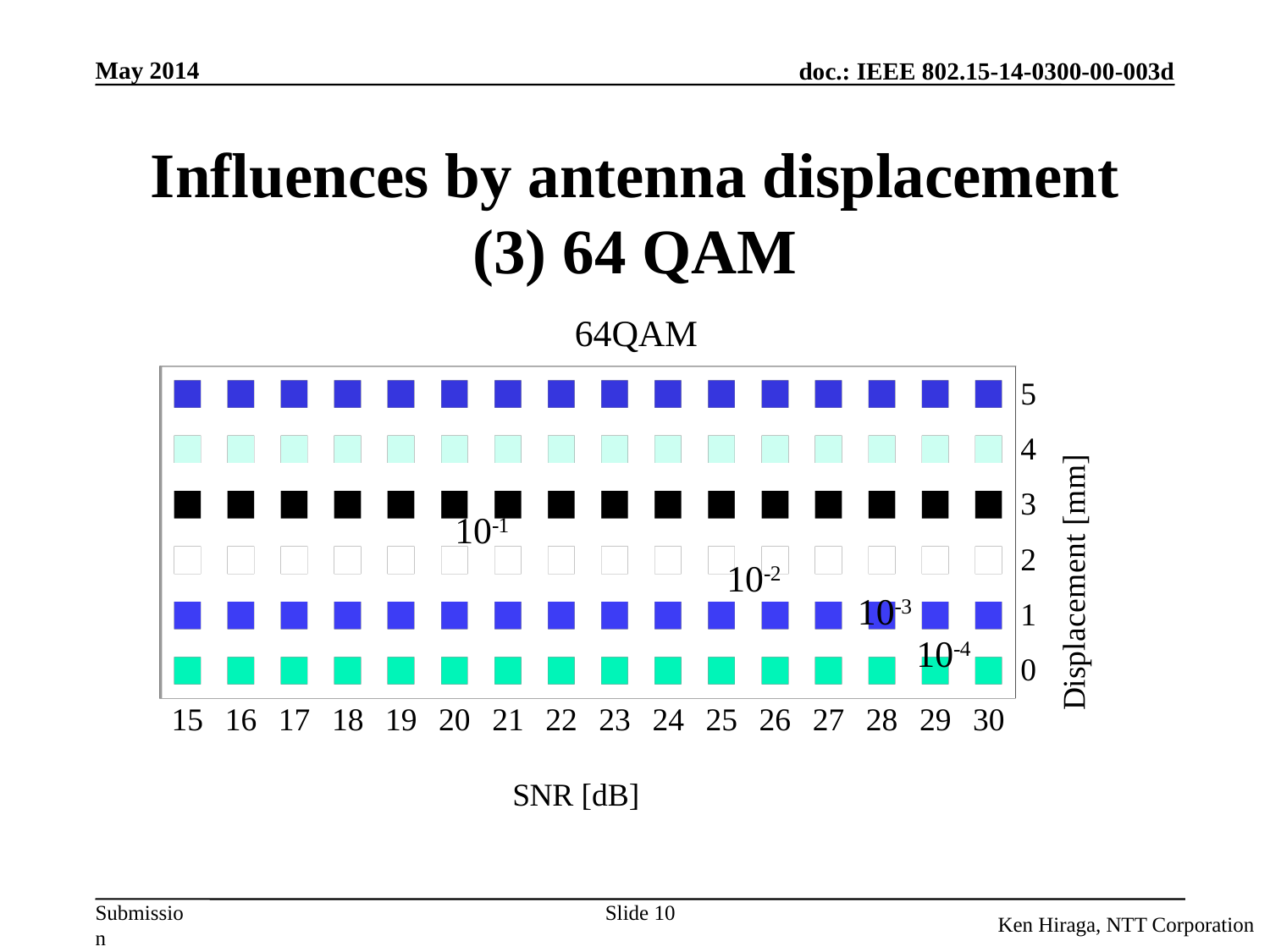
How many SNR values are shown along the x axis of the chart? 16 What is the lowest displacement value shown on the y axis of the chart? 0 What is the lowest SNR value shown on the x axis of the chart? 15 What kind of chart is shown on the slide? heat map (surface chart) What is the label of the x axis of the chart? SNR [dB] What is the highest SNR value shown on the x axis of the chart? 30 What is the title of the chart? 64QAM How many data points are plotted in the chart? 96 How many displacement levels are shown along the y axis of the chart? 6 What is the highest displacement value shown on the y axis of the chart? 5